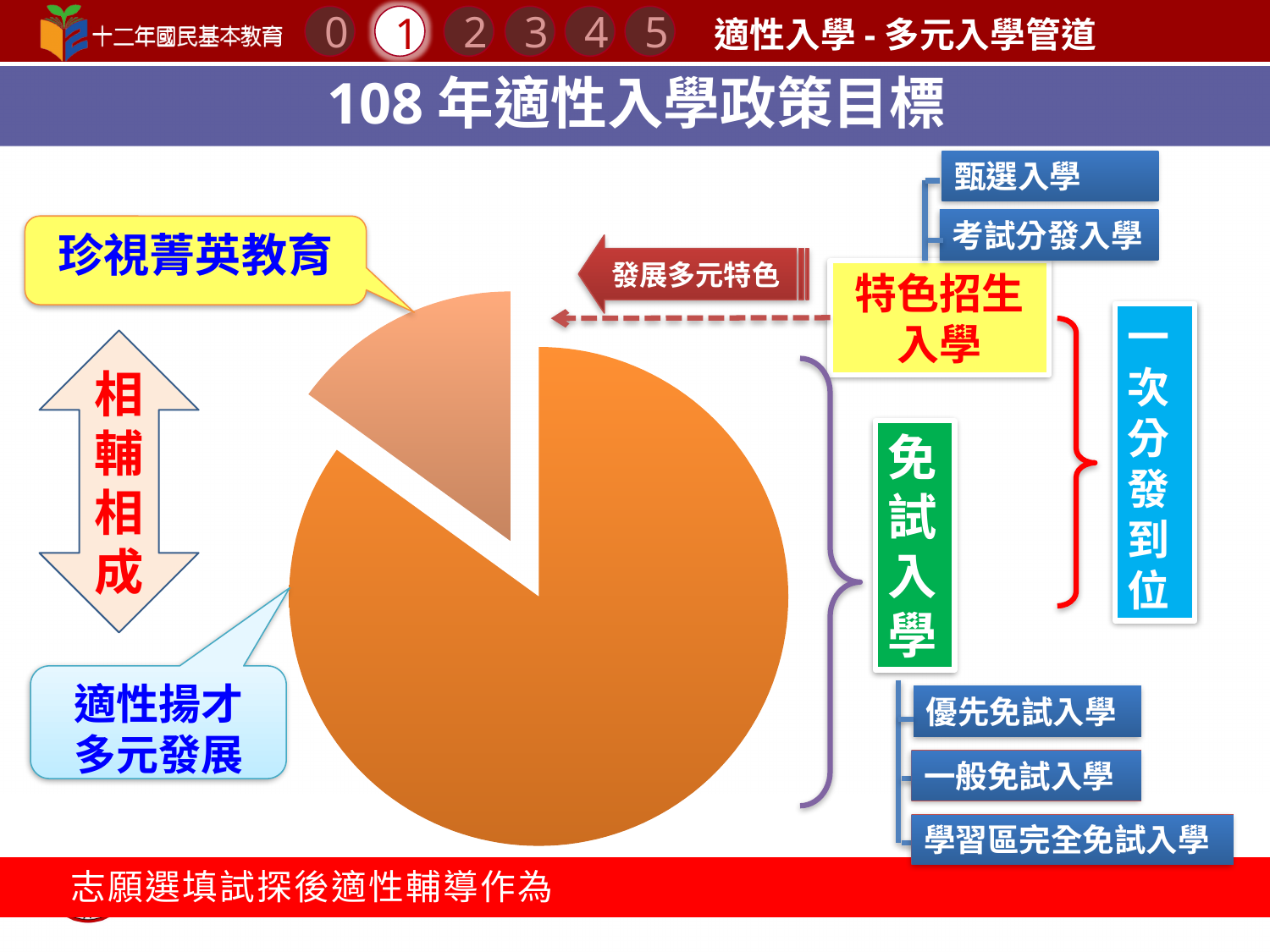
Which slice of the pie chart is the largest? 免試入學 What is the title of the slide containing the pie chart? 108 年適性入學政策目標 Which slice of the pie chart is the smallest? 特色招生入學 Is the 免試入學 slice more or less than half of the pie? more How many slices does the pie chart have? 2 Which slice is larger, 免試入學 or 特色招生入學? 免試入學 Which slice of the pie chart is pulled out (exploded) from the rest of the pie? 特色招生入學 What kind of chart is shown on the slide? pie chart